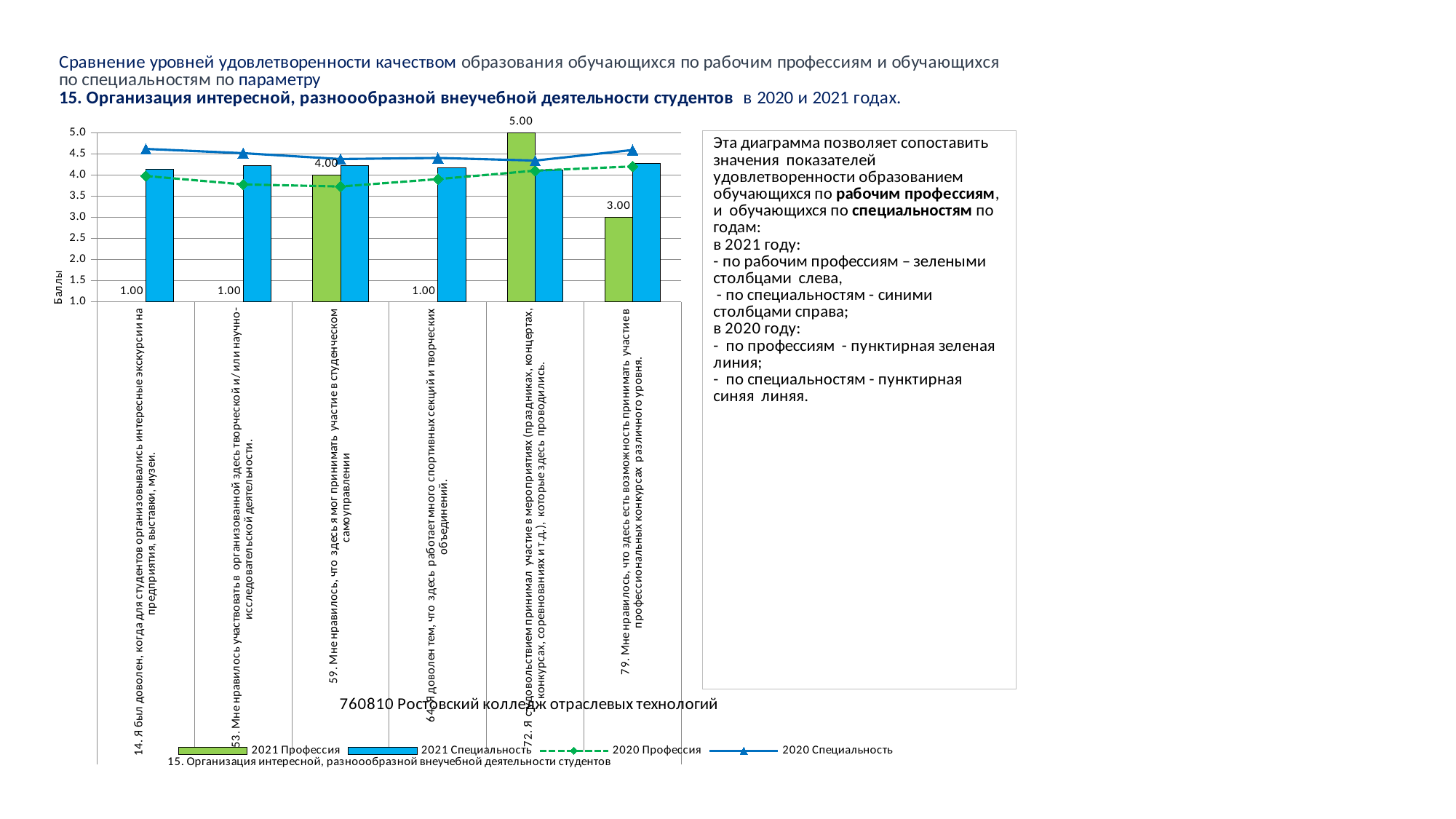
Which series is shown as a dashed green line? 2020 Профессия How many categories (questions) are plotted along the x axis? 6 Which category has the highest 2021 Профессия value? 72. Я с удовольствием принимал участие в мероприятиях (праздниках, концертах, конкурсах, соревнованиях и т.д.) Which is larger: the 2021 Профессия value for question 59 or for question 79? Question 59 What is the difference between the 2021 Профессия values for question 72 and question 79? 2.00 What is the value of the 2021 Профессия bar for question 59 (Мне нравилось, что здесь я мог принимать участие в студенческом самоуправлении)? 4.00 What is the value of the 2021 Профессия bar for question 79 (Мне нравилось, что здесь есть возможность принимать участие в профессиональных конкурсах)? 3.00 Is the 2021 Специальность value for question 14 greater or less than 3.5? greater What kind of chart is shown on the slide? A combined bar and line chart What is the value of the 2021 Профессия bar for question 72 (Я с удовольствием принимал участие в мероприятиях)? 5.00 What is the label of the vertical axis? Баллы How many series does the legend list? 4